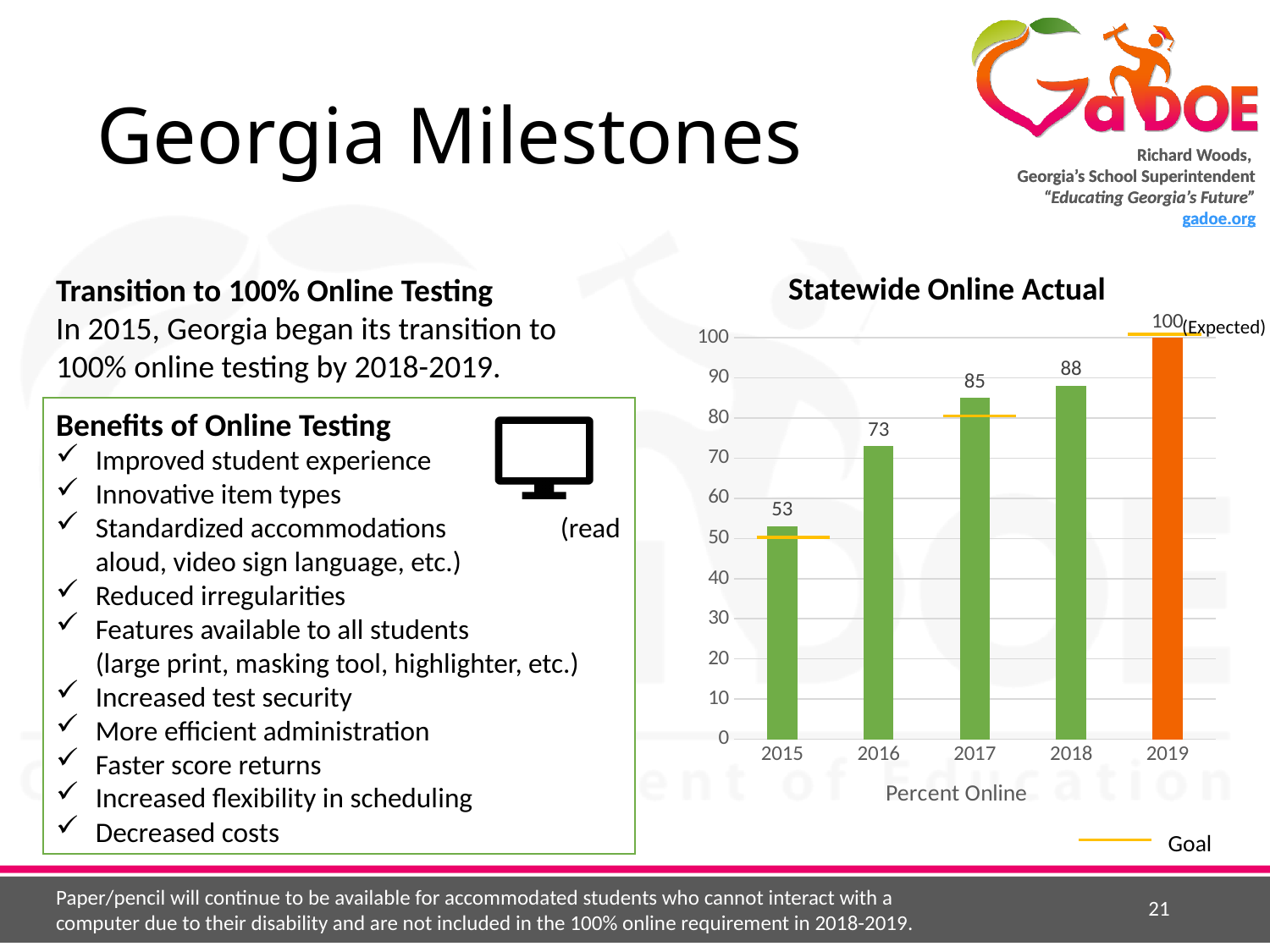
What is the value for 2015 in the Statewide Online Actual chart? 53 Which year has the highest value in the Statewide Online Actual chart? 2019 What type of chart is shown on the slide? bar chart What is the value for 2017 in the Statewide Online Actual chart? 85 Which year has the lowest value in the Statewide Online Actual chart? 2015 Do the values in the Statewide Online Actual chart rise or fall from 2015 to 2019? rise What label is shown on the x axis of the Statewide Online Actual chart? Percent Online What is the difference between the values for 2016 and 2015 in the Statewide Online Actual chart? 20 Which is larger in the Statewide Online Actual chart, the value for 2017 or the value for 2016? 2017 How many years are shown on the x axis of the Statewide Online Actual chart? 5 What is the value for 2018 in the Statewide Online Actual chart? 88 What is the title of the chart on the slide? Statewide Online Actual